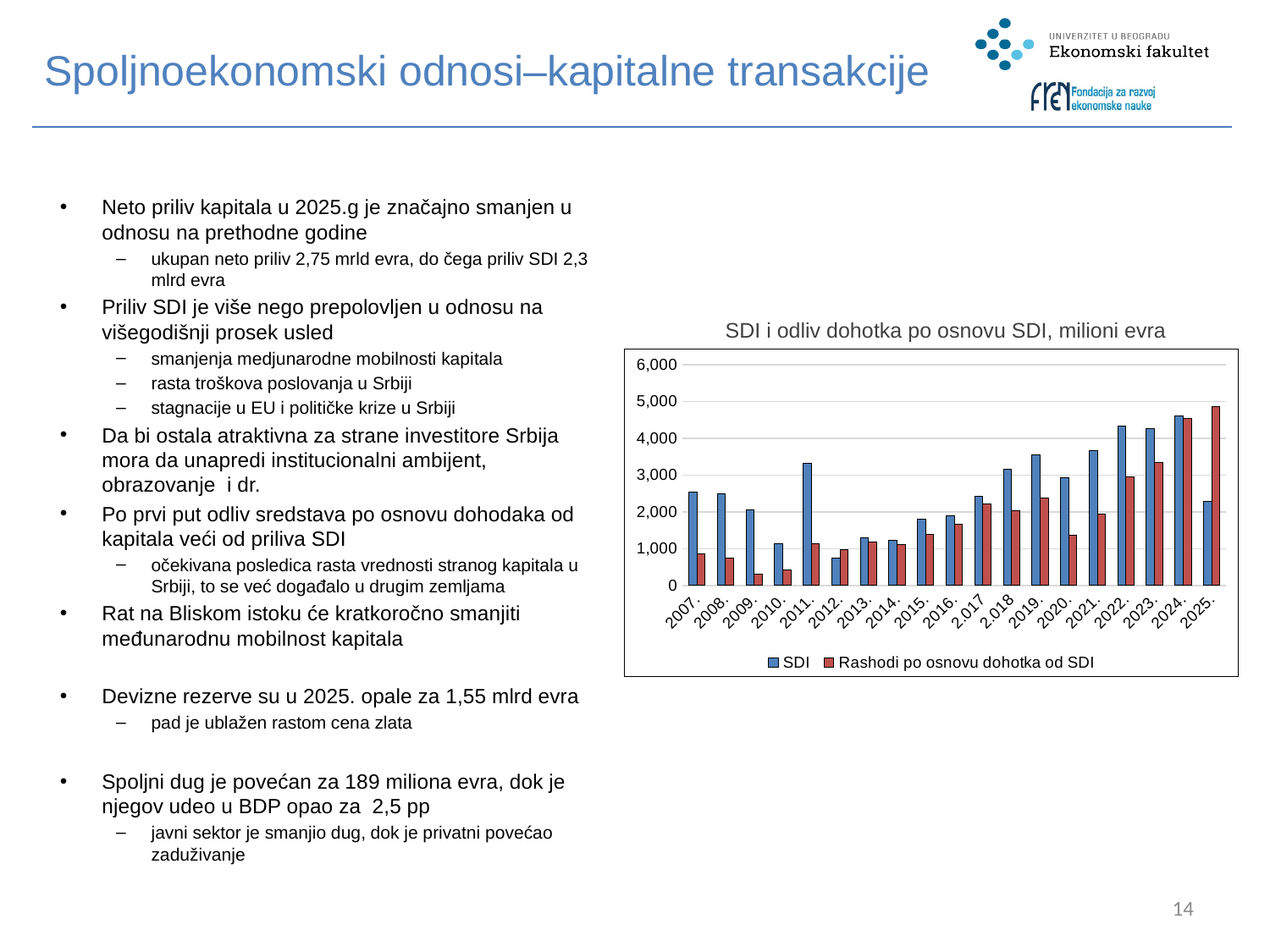
Is the SDI value for 2011 greater or less than 3,000? greater In 2007, which is larger: SDI or Rashodi po osnovu dohotka od SDI? SDI In which year is the value for Rashodi po osnovu dohotka od SDI the lowest? 2009. What is the title of the chart? SDI i odliv dohotka po osnovu SDI, milioni evra In which year is the SDI value the lowest? 2012. In which year is the value for Rashodi po osnovu dohotka od SDI the highest? 2025. How many years are shown on the x axis of the chart? 19 Is the value for Rashodi po osnovu dohotka od SDI in 2009 greater or less than 1,000? less In 2025, which is larger: SDI or Rashodi po osnovu dohotka od SDI? Rashodi po osnovu dohotka od SDI What kind of chart is shown on the slide? Bar chart In which year is the SDI value the highest? 2024. How many series does the chart legend list? 2